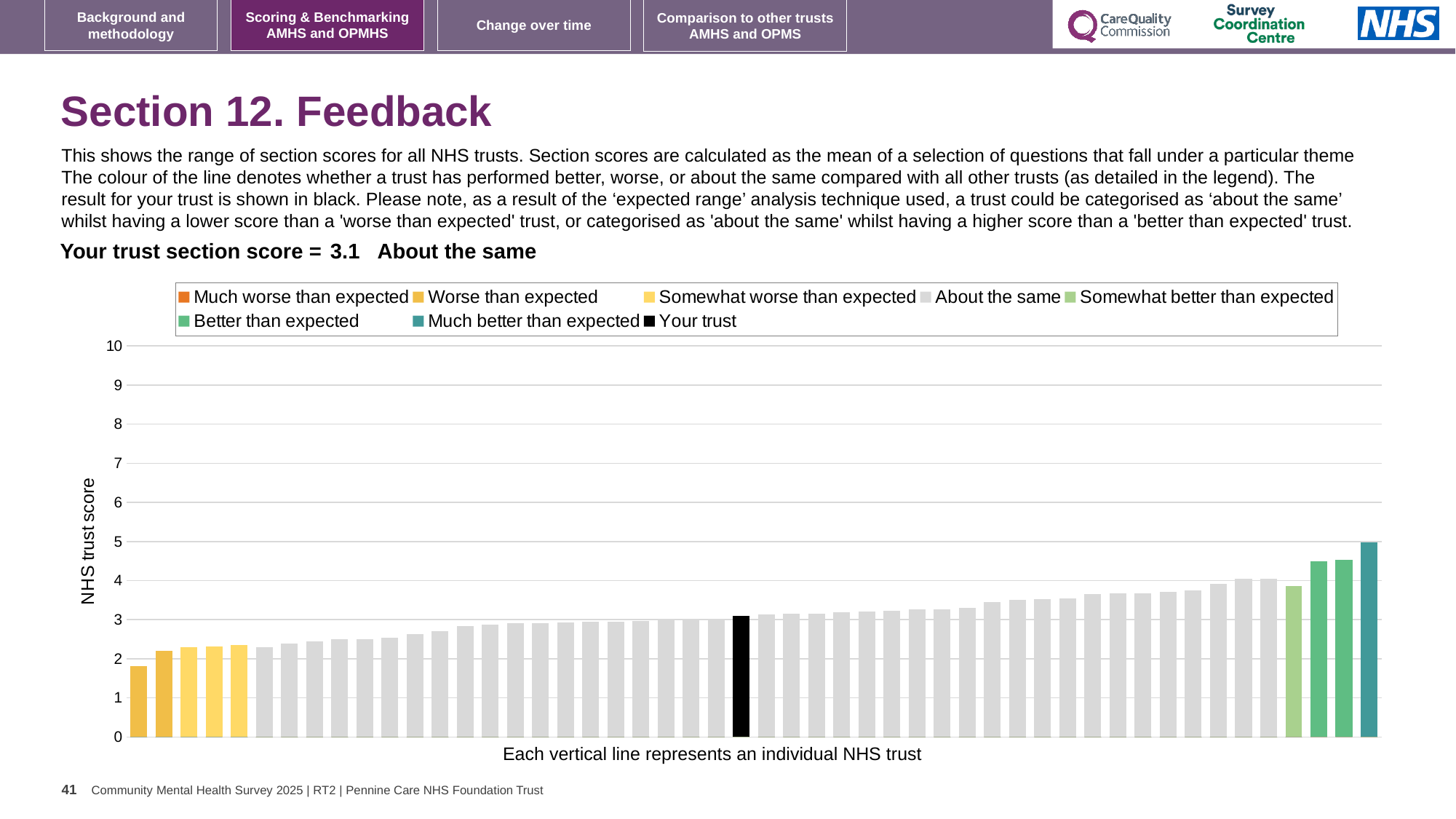
Is the value of the shortest bar greater or less than 2? less How many entries does the chart legend list? 8 Is the value for your trust greater or less than 3? greater Which category is your trust placed in for this section? About the same What kind of chart is shown on the slide? bar chart Which legend category does the tallest bar belong to? Much better than expected What is the section score for your trust? 3.1 Do the bar values rise or fall from left to right along the x axis? rise Is the value of the tallest bar greater or less than 4? greater Is the bar for your trust higher or lower than the leftmost bar? higher What is the title of the vertical axis? NHS trust score